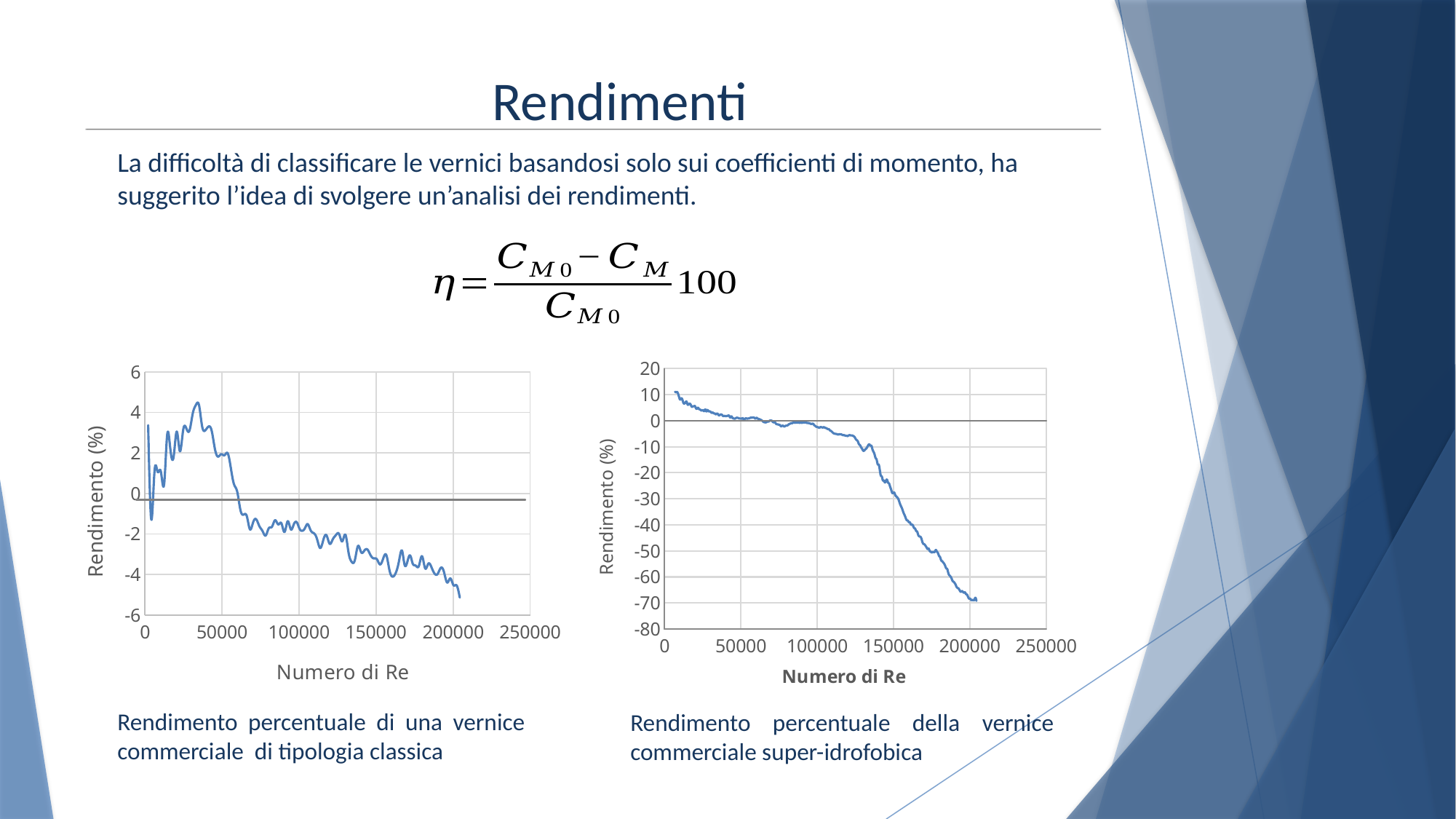
In the right chart (super-idrofobica), is the value at Numero di Re = 150000 greater or less than -10? less In the left chart (tipologia classica), is the value at Numero di Re = 100000 greater or less than 0? less What kind of chart is the left chart (Rendimento percentuale di una vernice commerciale di tipologia classica)? line chart In the left chart (tipologia classica), do the values rise or fall as Numero di Re increases from 50000 to 200000? fall In the left chart (tipologia classica), is the value at Numero di Re = 200000 greater or less than -2? less In the right chart (super-idrofobica), do the values rise or fall as Numero di Re increases? fall What is the y-axis title of the right chart (super-idrofobica)? Rendimento (%) What is the x-axis title of the left chart (tipologia classica)? Numero di Re What kind of chart is the right chart (Rendimento percentuale della vernice commerciale super-idrofobica)? line chart